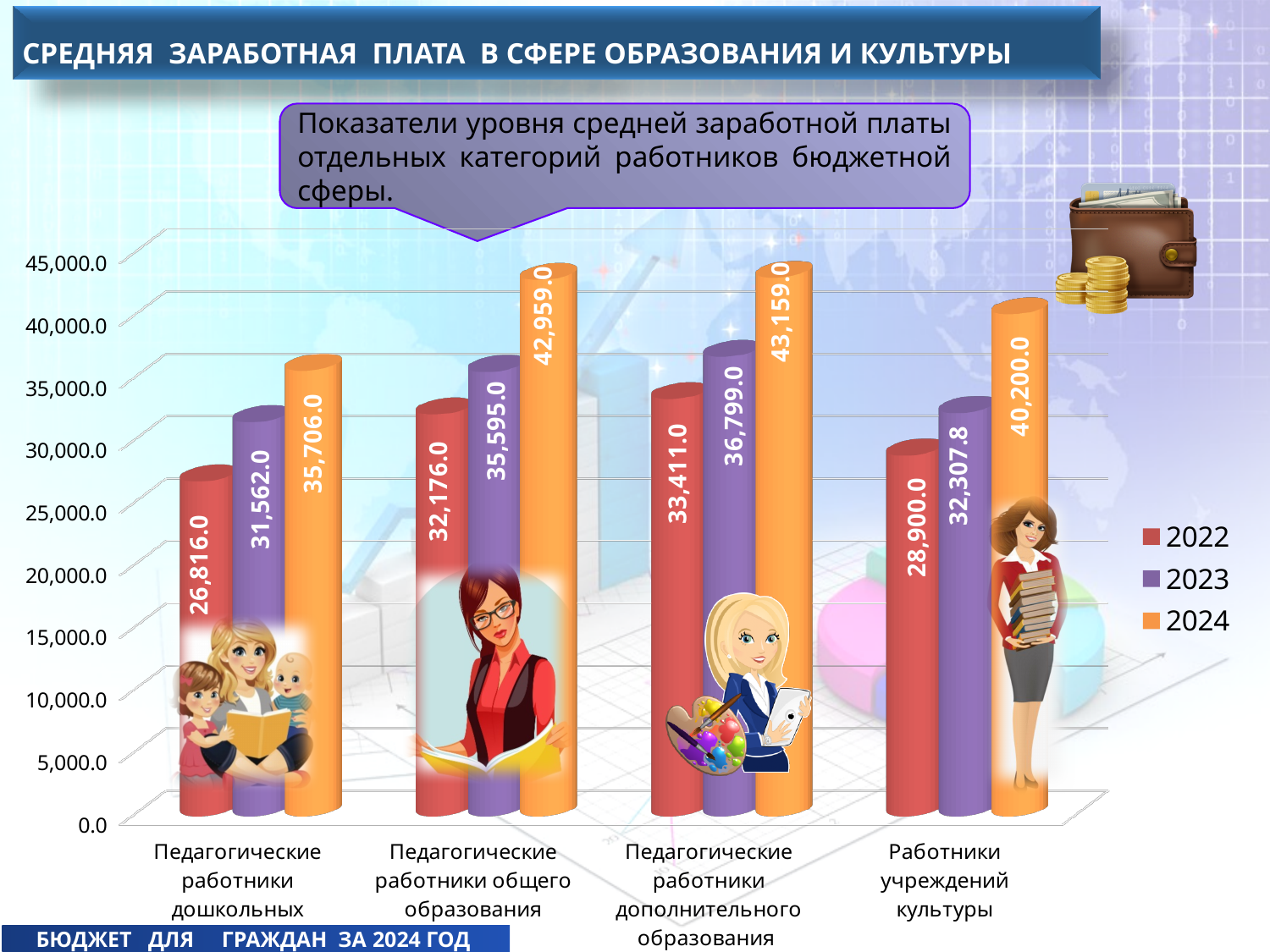
Which category has the lowest 2022 value? Педагогические работники дошкольных What is the difference between the 2024 and 2022 values for Работники учреждений культуры? 11,300.0 Do the values for Педагогические работники общего образования rise or fall from 2022 to 2024? Rise How many series does the legend list? 3 Which category has the highest 2024 value? Педагогические работники дополнительного образования What kind of chart is shown on the slide? Bar chart What is the 2024 value for Педагогические работники общего образования? 42,959.0 What is the 2023 value for Педагогические работники дополнительного образования? 36,799.0 What is the 2022 value for Работники учреждений культуры? 28,900.0 What is the difference between the 2024 and 2023 values for Педагогические работники дополнительного образования? 6,360.0 What is the 2023 value for Работники учреждений культуры? 32,307.8 Which is larger: the 2023 value for Педагогические работники дополнительного образования or the 2023 value for Работники учреждений культуры? Педагогические работники дополнительного образования